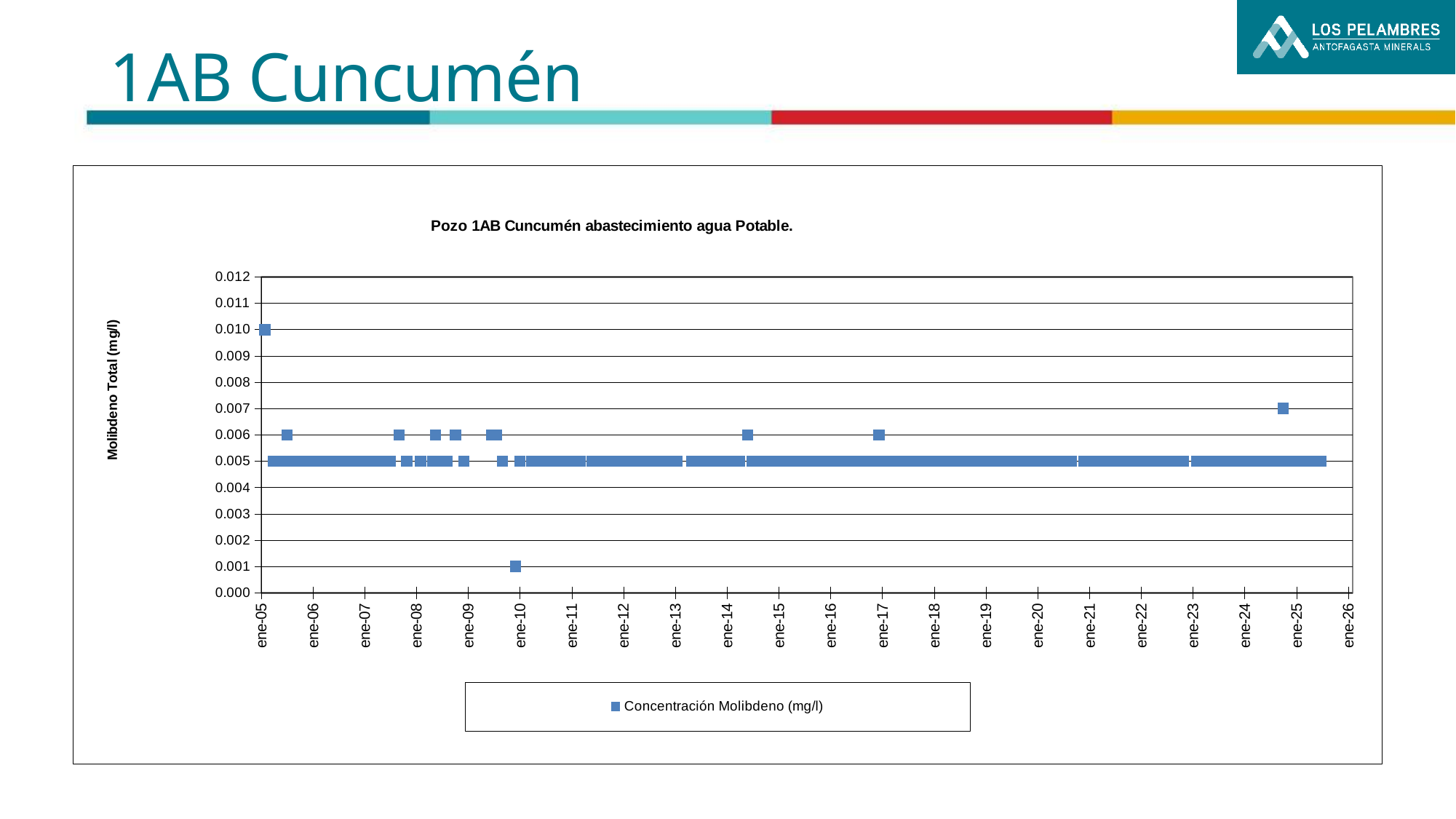
What is the title of the chart? Pozo 1AB Cuncumén abastecimiento agua Potable. Which is larger: the point plotted at ene-05 or the point plotted near ene-10 at the bottom of the chart? the point at ene-05 What kind of chart is shown on the slide? scatter chart At which value do most of the plotted points lie? 0.005 What is the value of the isolated point plotted shortly before ene-25? 0.007 What is the lowest molybdenum concentration value plotted on the chart? 0.001 What is the highest molybdenum concentration value plotted on the chart? 0.010 How many series does the legend list? 1 Is the value of the lowest point, plotted near ene-10, greater or less than 0.002? less Is the value of the point plotted shortly before ene-25 greater or less than 0.006? greater What is the difference between the highest plotted value and the lowest plotted value? 0.009 What is the label of the series in the legend? Concentración Molibdeno (mg/l)